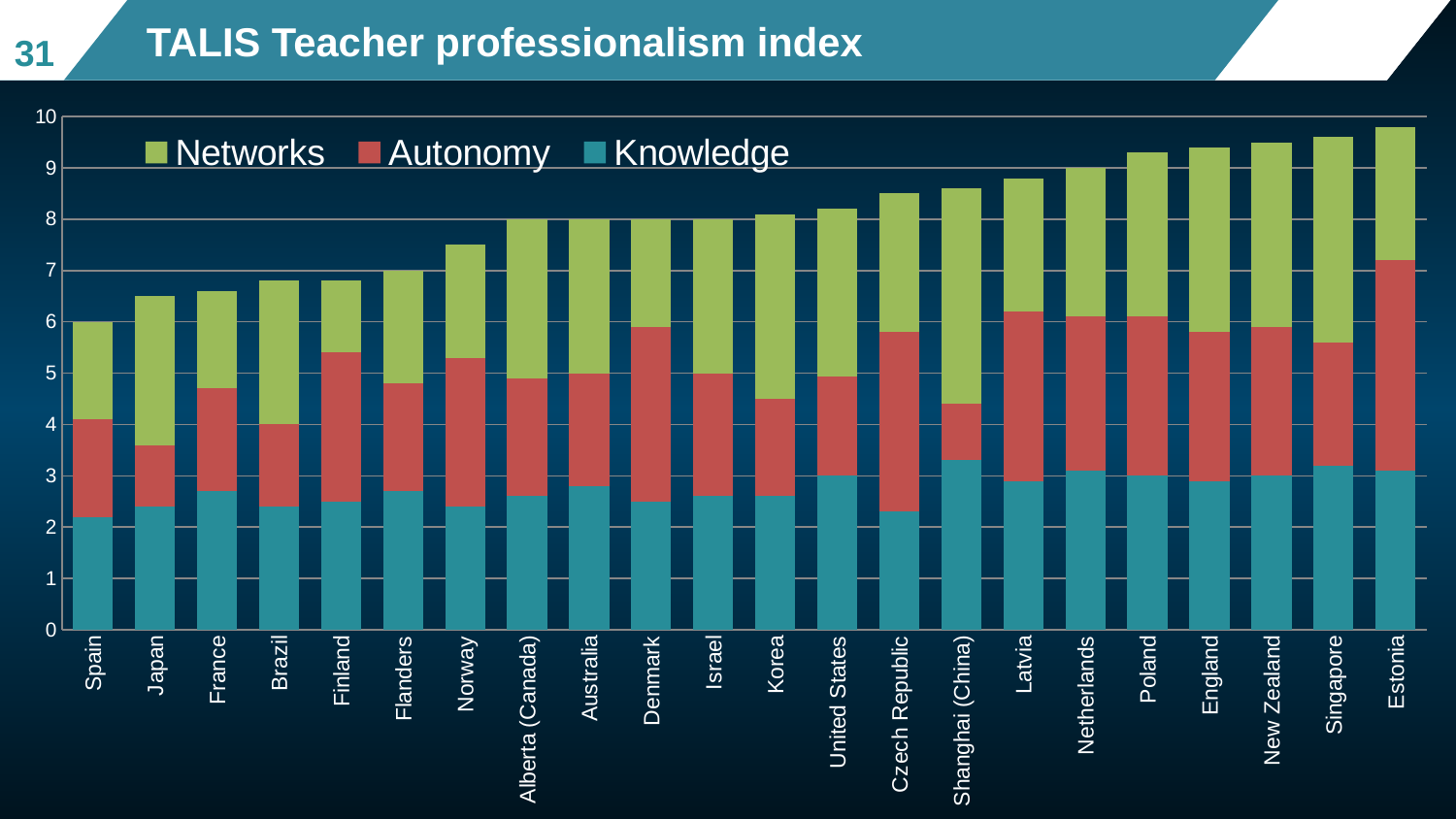
Do the total bar heights rise or fall from left to right along the x axis? Rise How many countries or regions are shown on the x axis? 22 Which country has the lowest total teacher professionalism index? Spain What is the title of the chart? TALIS Teacher professionalism index What kind of chart is shown on the slide? Stacked bar chart Is the total value for Latvia greater or less than 8? greater Which country has the highest total teacher professionalism index? Estonia Which has a larger total index, Singapore or France? Singapore Which country has the largest Autonomy segment? Estonia Is the total value for Estonia greater or less than 9? greater How many series does the legend list? 3 Is the total value for Japan greater or less than 7? less